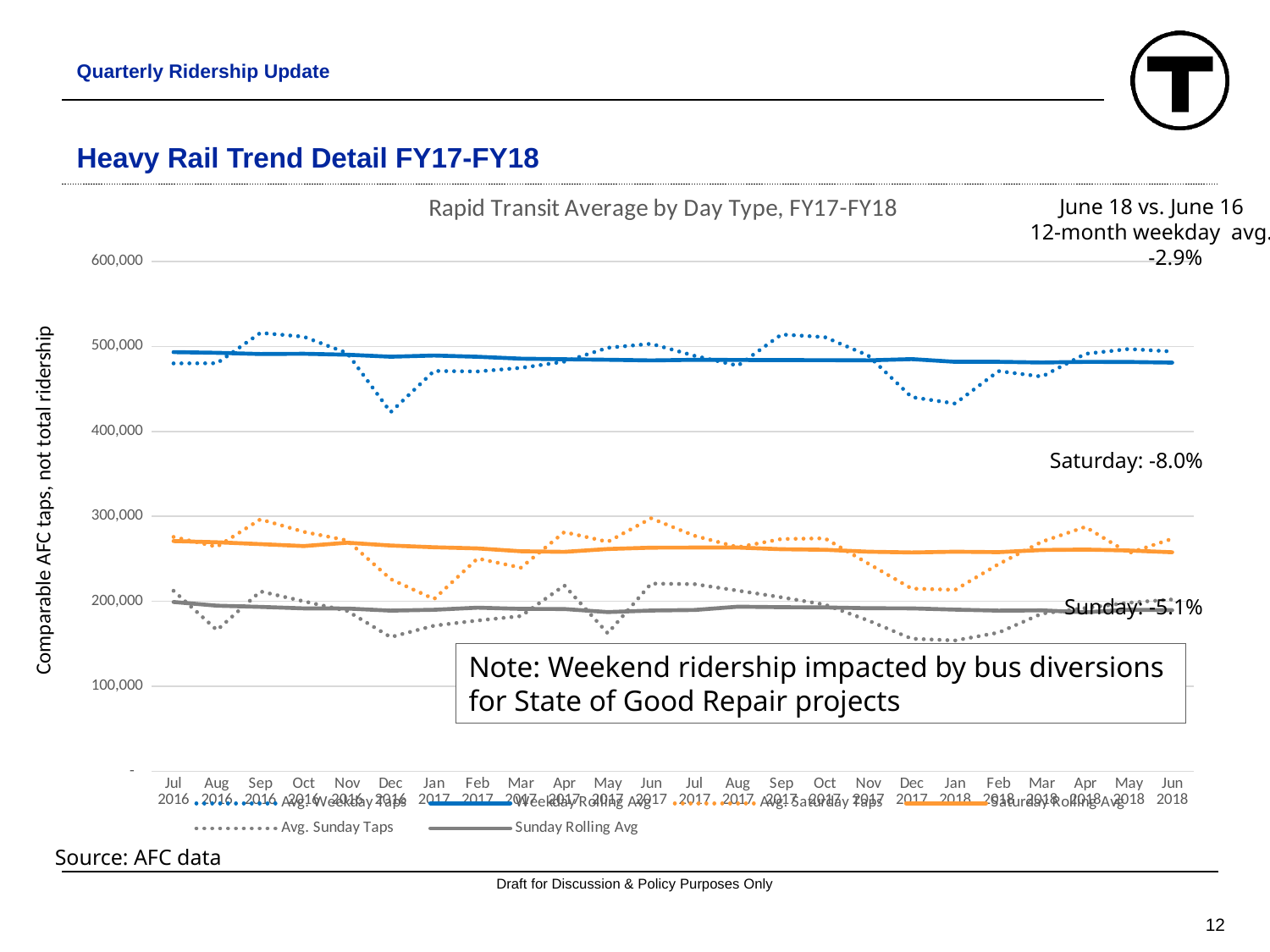
Is the value for Avg. Sunday Taps in Jan 2018 greater or less than 200,000? less Is the Saturday Rolling Avg in Jun 2018 greater or less than 300,000? less What kind of chart is shown on the slide? line chart Does the Weekday Rolling Avg rise or fall from Jul 2016 to Jun 2018? fall Is the value for Avg. Weekday Taps in Sep 2016 greater or less than 500,000? greater Which series has the highest values throughout the chart: Weekday Rolling Avg, Saturday Rolling Avg, or Sunday Rolling Avg? Weekday Rolling Avg How many months are plotted along the x axis of the chart? 24 What is the title of the chart? Rapid Transit Average by Day Type, FY17-FY18 What is the label on the vertical axis of the chart? Comparable AFC taps, not total ridership How many series does the chart legend list? 6 In Jun 2017, which is larger: Avg. Saturday Taps or Avg. Sunday Taps? Avg. Saturday Taps